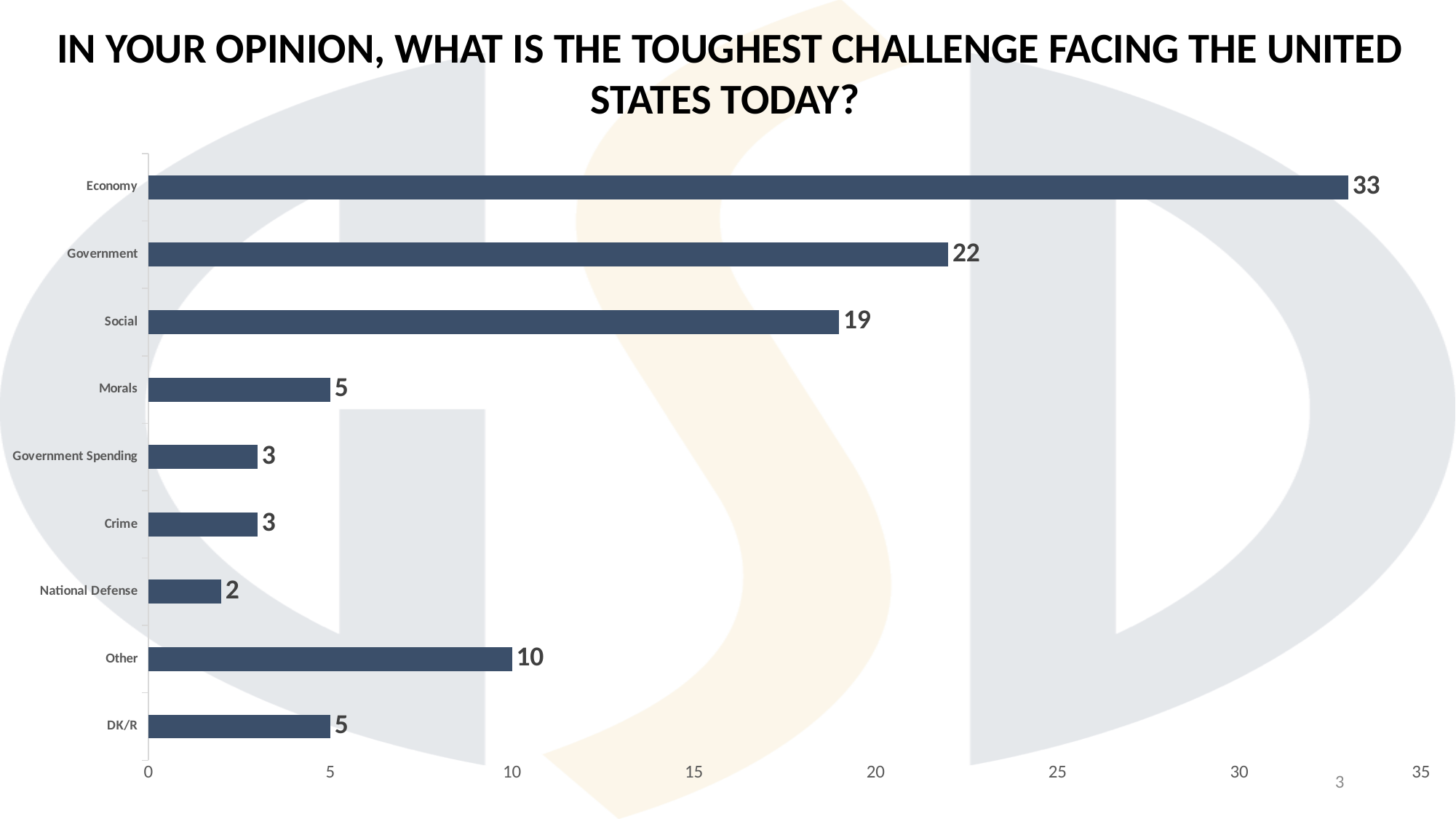
What is the difference between the values for Economy and Government? 11 What is the value for Economy? 33 How many categories are shown in the chart? 9 What is the value for Other? 10 What kind of chart is shown on the slide? Bar chart Which category has the lowest value? National Defense What is the title of the chart? In your opinion, what is the toughest challenge facing the United States today? Which is larger, the value for Social or the value for Other? Social What is the value for Social? 19 Which category has the highest value? Economy What is the value for National Defense? 2 What is the value for Government? 22